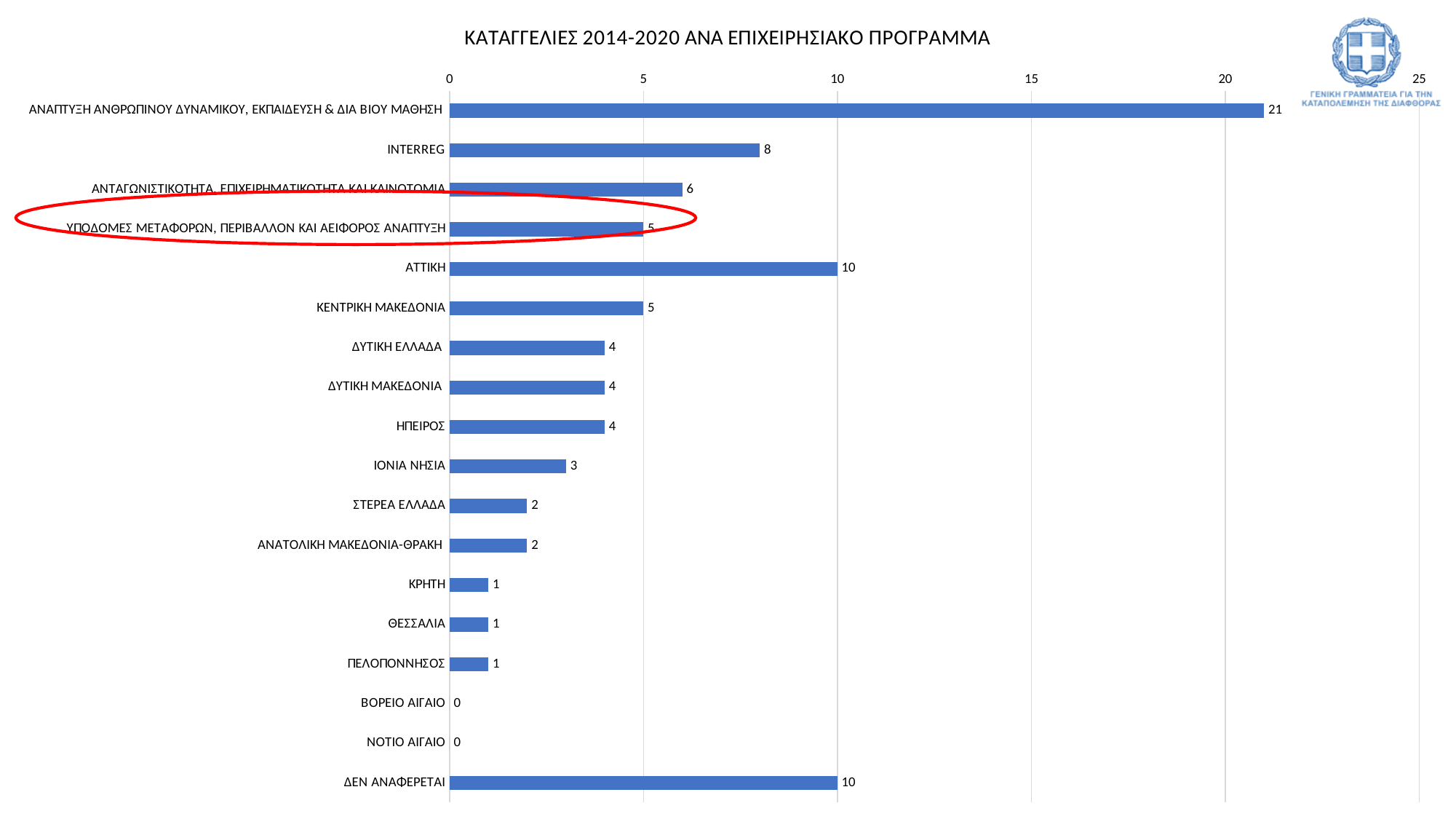
What is the value for ΥΠΟΔΟΜΕΣ ΜΕΤΑΦΟΡΩΝ, ΠΕΡΙΒΑΛΛΟΝ ΚΑΙ ΑΕΙΦΟΡΟΣ ΑΝΑΠΤΥΞΗ? 5 What is the title of the chart? ΚΑΤΑΓΓΕΛΙΕΣ 2014-2020 ΑΝΑ ΕΠΙΧΕΙΡΗΣΙΑΚΟ ΠΡΟΓΡΑΜΜΑ What is the difference between the values for ΑΤΤΙΚΗ and ΚΕΝΤΡΙΚΗ ΜΑΚΕΔΟΝΙΑ? 5 What is the value for ΑΤΤΙΚΗ? 10 What kind of chart is shown on the slide? bar chart Which has a larger value, ΑΝΤΑΓΩΝΙΣΤΙΚΟΤΗΤΑ, ΕΠΙΧΕΙΡΗΜΑΤΙΚΟΤΗΤΑ ΚΑΙ ΚΑΙΝΟΤΟΜΙΑ or ΙΟΝΙΑ ΝΗΣΙΑ? ΑΝΤΑΓΩΝΙΣΤΙΚΟΤΗΤΑ, ΕΠΙΧΕΙΡΗΜΑΤΙΚΟΤΗΤΑ ΚΑΙ ΚΑΙΝΟΤΟΜΙΑ Which category has the highest value? ΑΝΑΠΤΥΞΗ ΑΝΘΡΩΠΙΝΟΥ ΔΥΝΑΜΙΚΟΥ, ΕΚΠΑΙΔΕΥΣΗ & ΔΙΑ ΒΙΟΥ ΜΑΘΗΣΗ What is the value for INTERREG? 8 What is the difference between the values for ΑΝΑΠΤΥΞΗ ΑΝΘΡΩΠΙΝΟΥ ΔΥΝΑΜΙΚΟΥ, ΕΚΠΑΙΔΕΥΣΗ & ΔΙΑ ΒΙΟΥ ΜΑΘΗΣΗ and INTERREG? 13 What is the value for ΙΟΝΙΑ ΝΗΣΙΑ? 3 How many categories are shown in the chart? 18 Is the value for ΑΝΑΠΤΥΞΗ ΑΝΘΡΩΠΙΝΟΥ ΔΥΝΑΜΙΚΟΥ, ΕΚΠΑΙΔΕΥΣΗ & ΔΙΑ ΒΙΟΥ ΜΑΘΗΣΗ greater or less than 20? greater